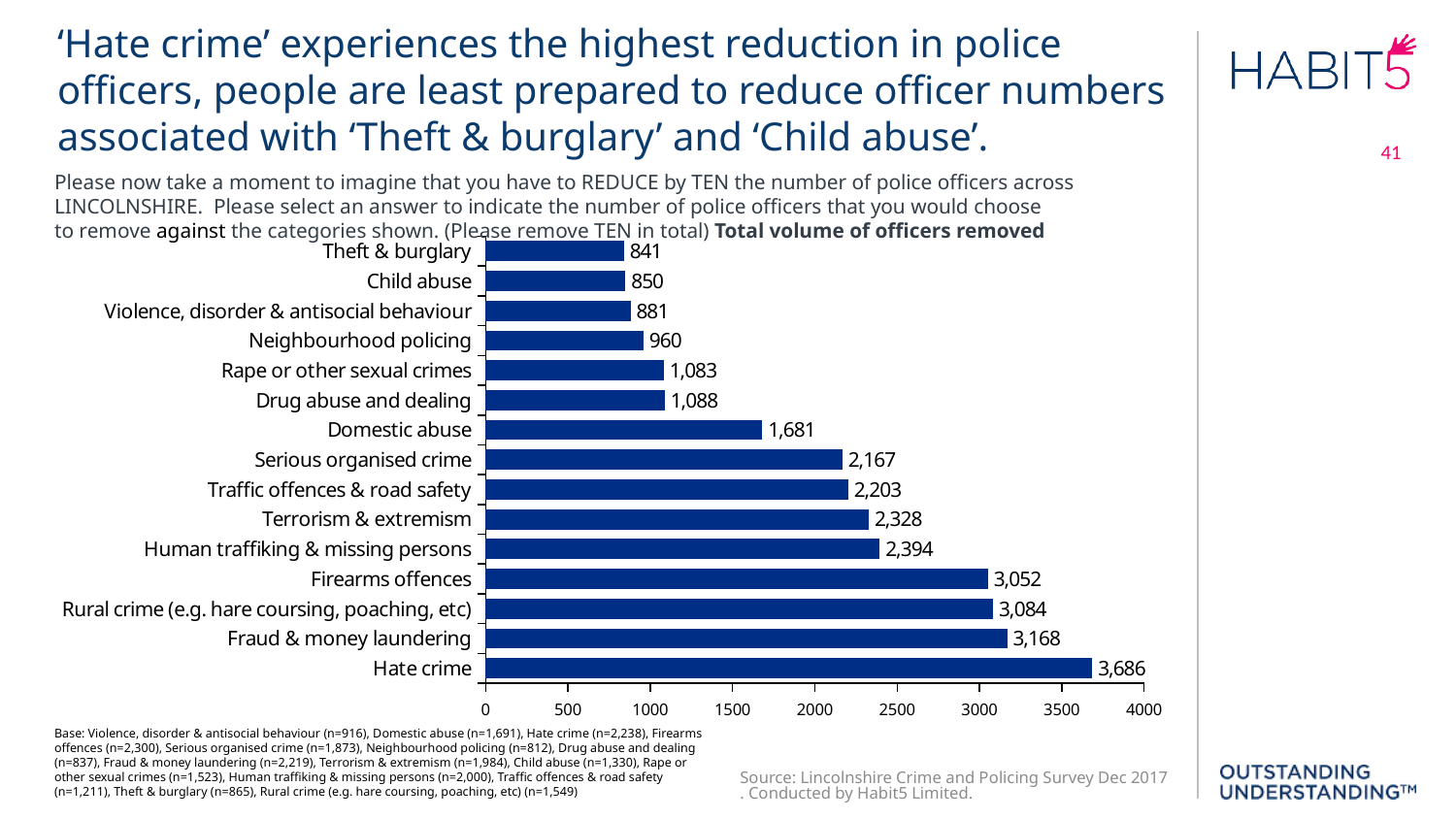
What kind of chart is shown on the slide? Bar chart What is the difference between the values for Firearms offences and Domestic abuse? 1,371 Which category has the highest total volume of officers removed? Hate crime How many categories are shown in the chart? 15 What is the difference between the values for Hate crime and Fraud & money laundering? 518 What is the value shown for Domestic abuse? 1,681 Which category has the lowest total volume of officers removed? Theft & burglary Is the value for Human traffiking & missing persons greater or less than 2000? greater What is the value shown for Neighbourhood policing? 960 Which has a larger value, Terrorism & extremism or Serious organised crime? Terrorism & extremism What is the title of the chart? Total volume of officers removed What is the total volume of officers removed for Hate crime? 3,686